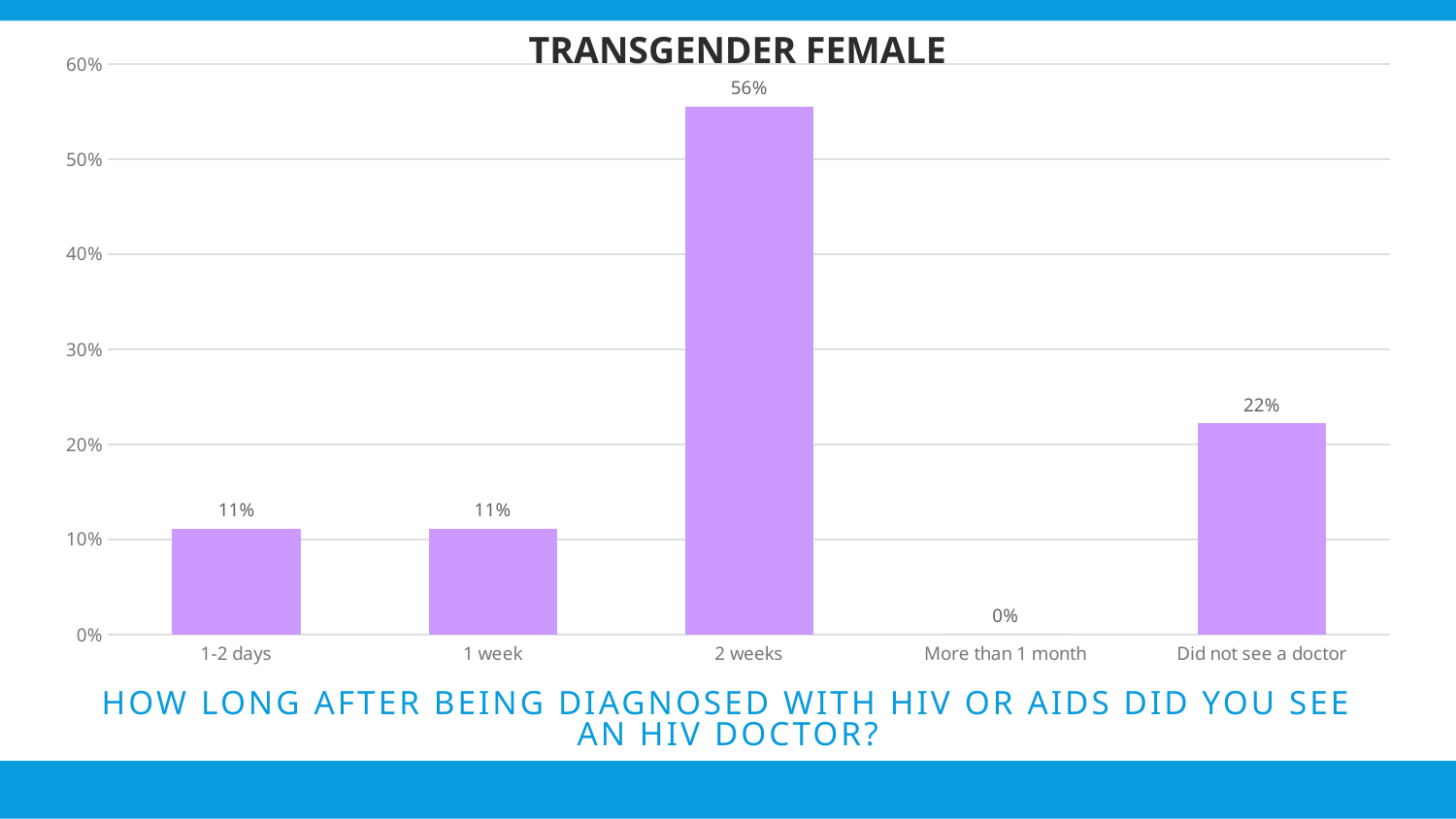
What is the difference between the values for 2 weeks and Did not see a doctor? 34% Which is larger, the value for 1 week or the value for Did not see a doctor? Did not see a doctor What is the title of the chart? TRANSGENDER FEMALE What is the value for Did not see a doctor? 22% Is the value for 2 weeks greater or less than 50%? greater What is the value for 1-2 days? 11% What kind of chart is shown on the slide? bar chart Which category has the lowest value? More than 1 month Which category has the highest value? 2 weeks How many categories are shown on the x axis? 5 What is the value for 2 weeks? 56% What is the value for More than 1 month? 0%